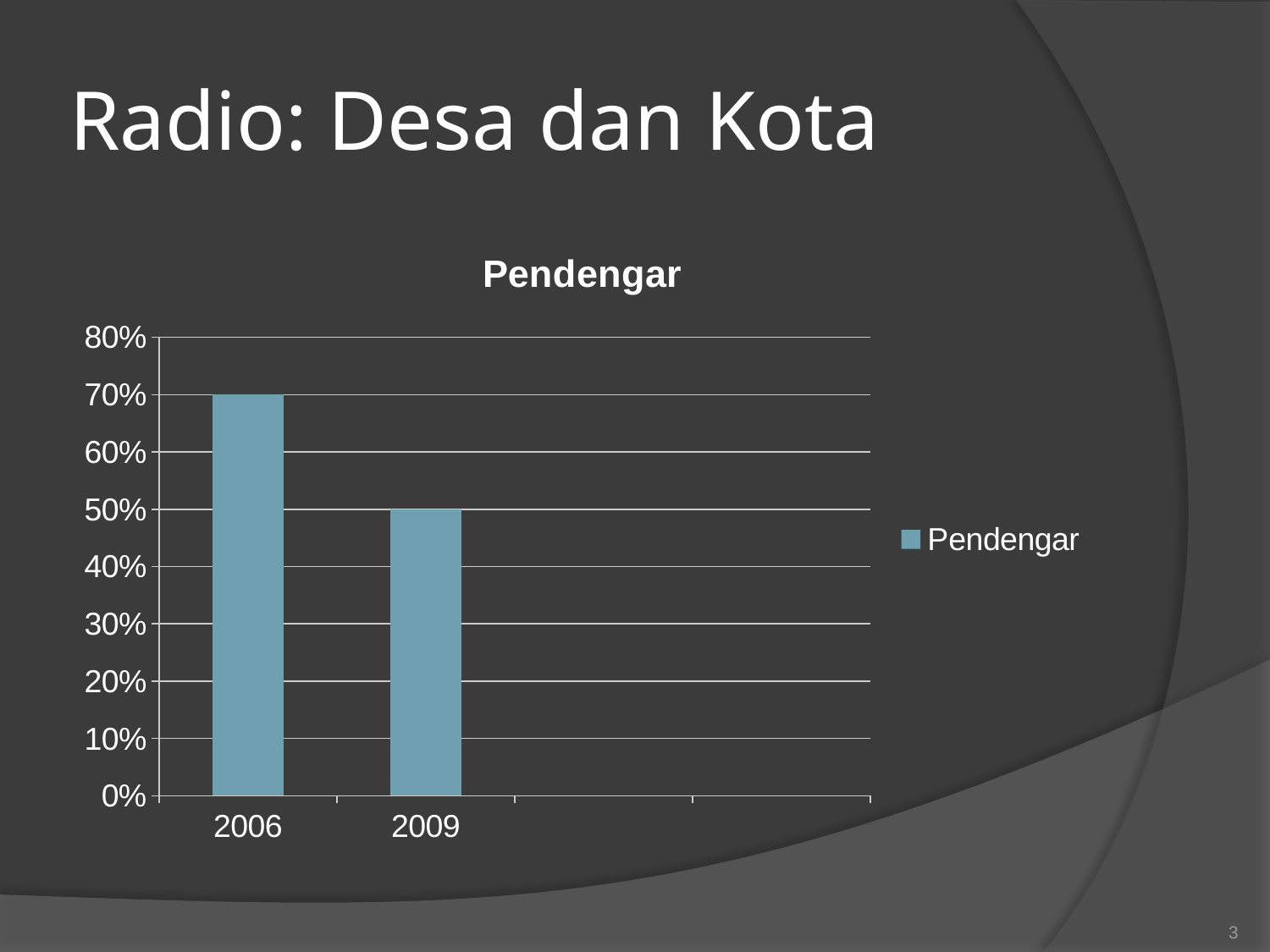
Which year has the highest value in the Pendengar chart? 2006 What is the value for 2006 in the Pendengar chart? 70% What is the value for 2009 in the Pendengar chart? 50% How many series does the legend of the Pendengar chart list? 1 What is the difference between the 2006 and 2009 values in the Pendengar chart? 20% Is the value for 2009 in the Pendengar chart greater or less than 60%? less Do the values in the Pendengar chart rise or fall from 2006 to 2009? fall Which year has the lowest value in the Pendengar chart? 2009 How many years are shown on the x axis of the Pendengar chart? 2 Is the value for 2006 in the Pendengar chart greater or less than 60%? greater Which is larger in the Pendengar chart, the value for 2006 or the value for 2009? 2006 What kind of chart is the Pendengar chart? bar chart